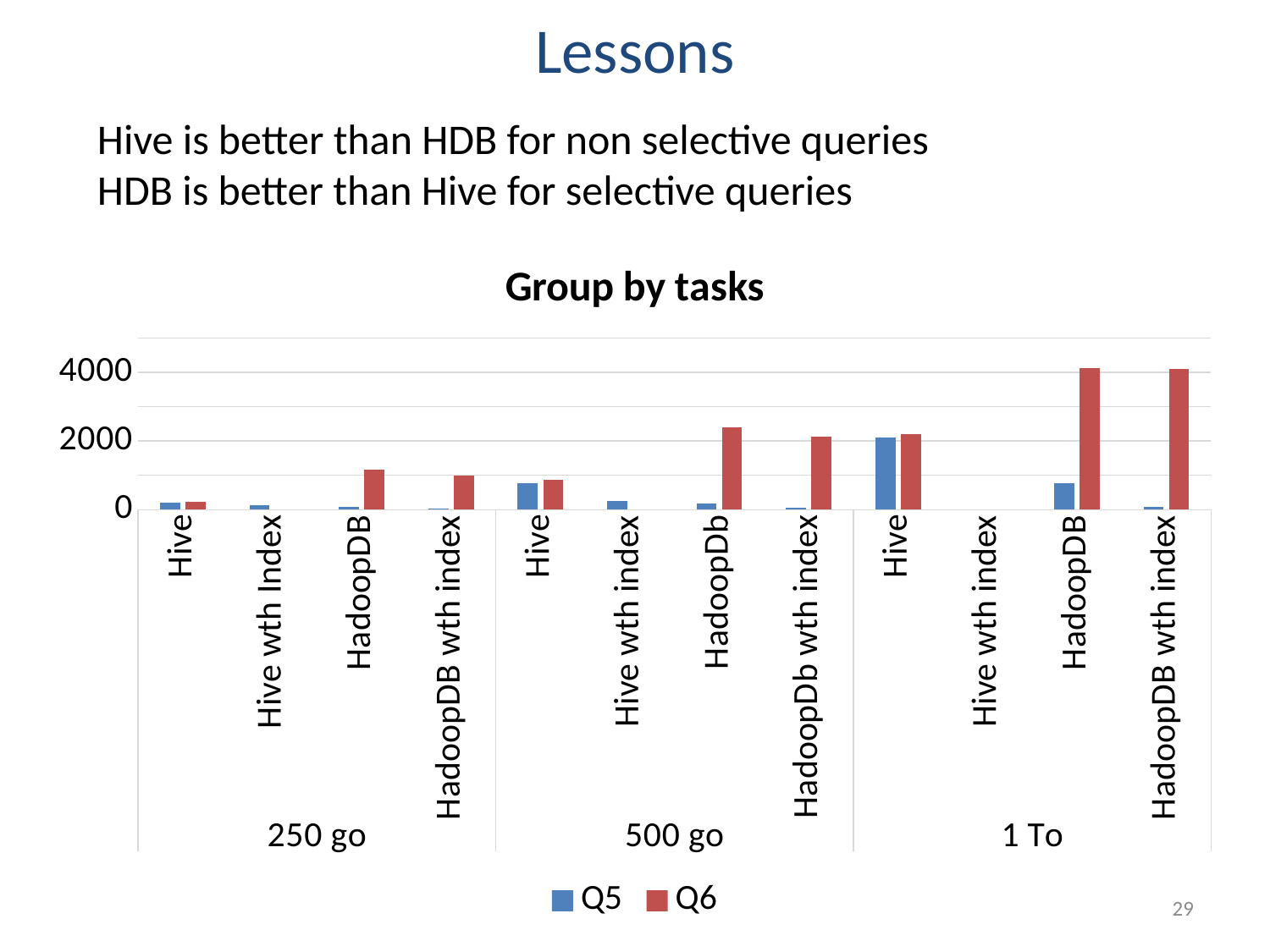
In the 500 go group, which is larger for HadoopDb: Q5 or Q6? Q6 Which series is drawn in red? Q6 How many series does the legend list? 2 Is the Q6 value for HadoopDB in the 250 go group greater or less than 2000? less What is the title of the chart? Group by tasks Is the Q5 value for Hive in the 1 To group greater or less than 4000? less What kind of chart is shown on the slide? bar chart Is the Q6 value for HadoopDB in the 1 To group greater or less than 2000? greater Which data-size group has the highest Q6 value for HadoopDB? 1 To Does the Q6 value for HadoopDB rise or fall as the data size increases from 250 go to 1 To? rise In the 1 To group, which is larger for Q5: Hive or HadoopDB? Hive How many data-size groups are shown along the x axis? 3